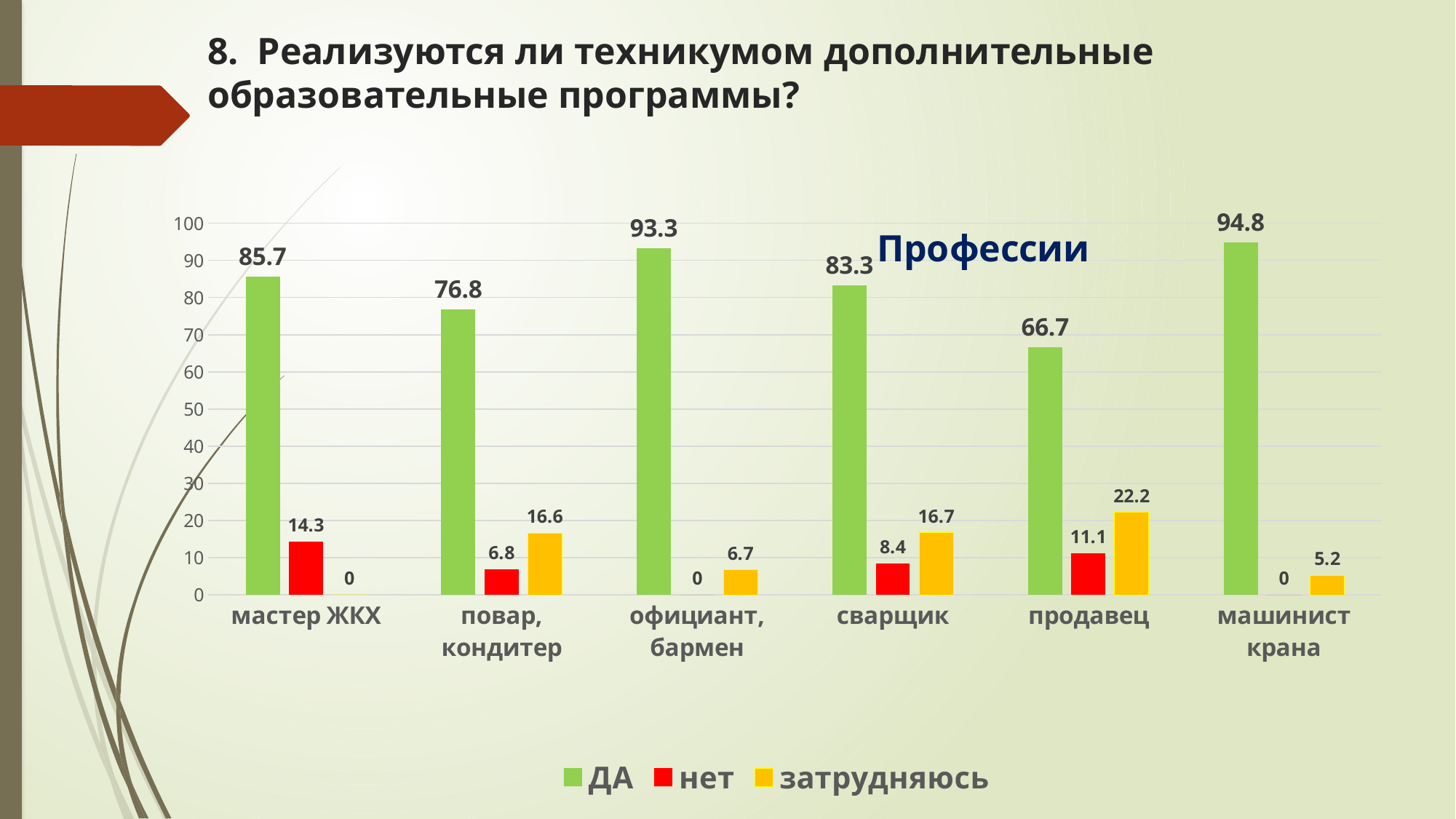
How many categories are shown on the x axis? 6 Which category has the highest ДА value? машинист крана What is the difference between the ДА values for машинист крана and продавец? 28.1 How many series does the legend list? 3 Which category has the lowest ДА value? продавец What is the value of the ДА series for официант, бармен? 93.3 Which colour represents the ДА series in the legend? green What is the value of the затрудняюсь series for продавец? 22.2 What is the value of the нет series for сварщик? 8.4 Which is larger: the нет value for мастер ЖКХ or the нет value for продавец? мастер ЖКХ What kind of chart is shown on the slide? bar chart What is the total of the three series values for повар, кондитер? 100.2